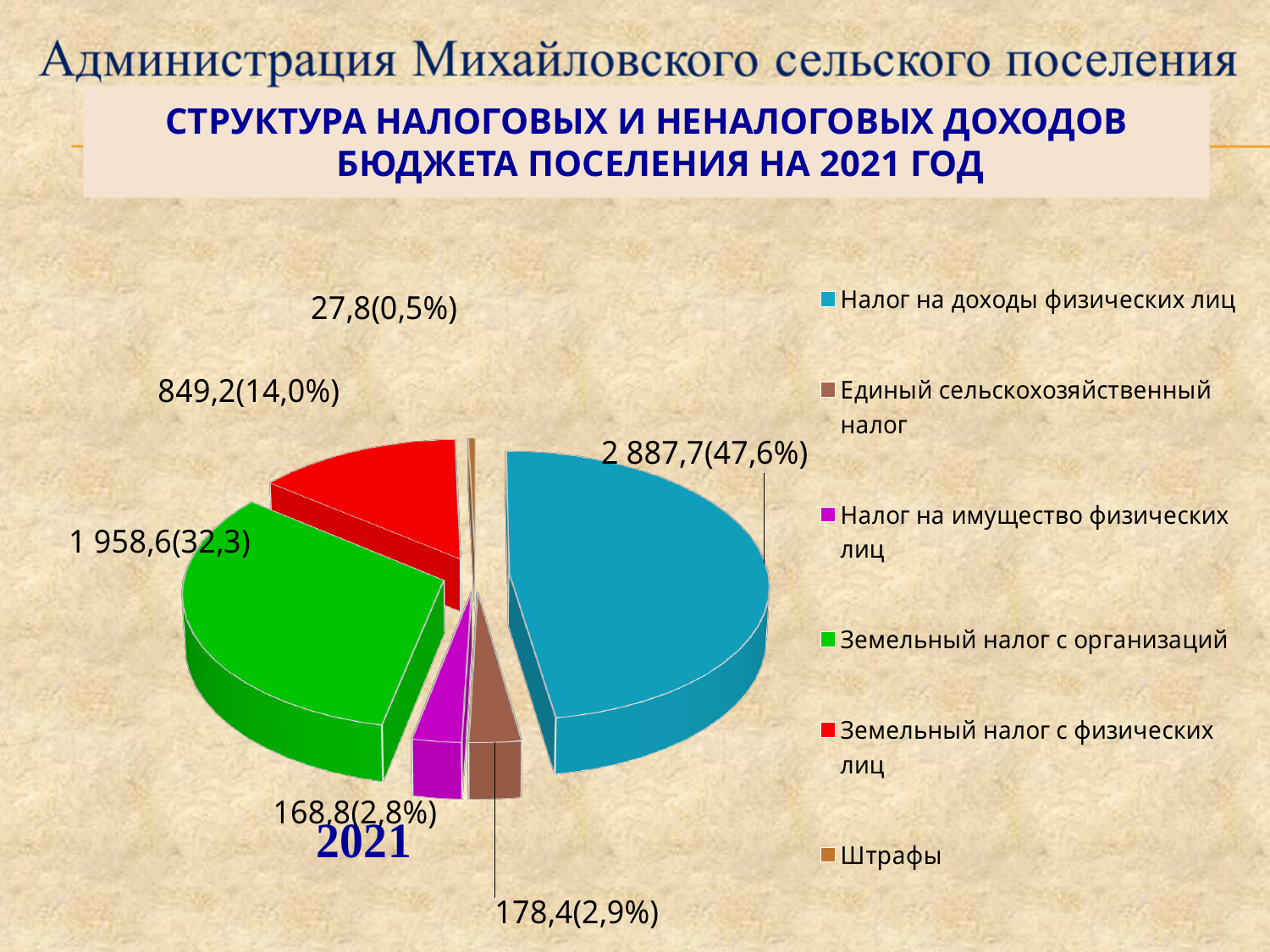
What value is shown for Земельный налог с организаций? 1 958,6(32,3) What kind of chart is shown on the slide? Pie chart What colour is the slice for Налог на доходы физических лиц? Blue Which category has the largest slice of the pie? Налог на доходы физических лиц Which is larger: Земельный налог с организаций or Земельный налог с физических лиц? Земельный налог с организаций What share of the pie does Налог на имущество физических лиц have? 2,8% What value is shown for Земельный налог с физических лиц? 849,2(14,0%) Which category has the smallest slice of the pie? Штрафы What value is shown for Штрафы? 27,8(0,5%) What value is shown for Налог на доходы физических лиц? 2 887,7(47,6%) How many categories does the legend of the pie chart list? 6 What value is shown for Единый сельскохозяйственный налог? 178,4(2,9%)